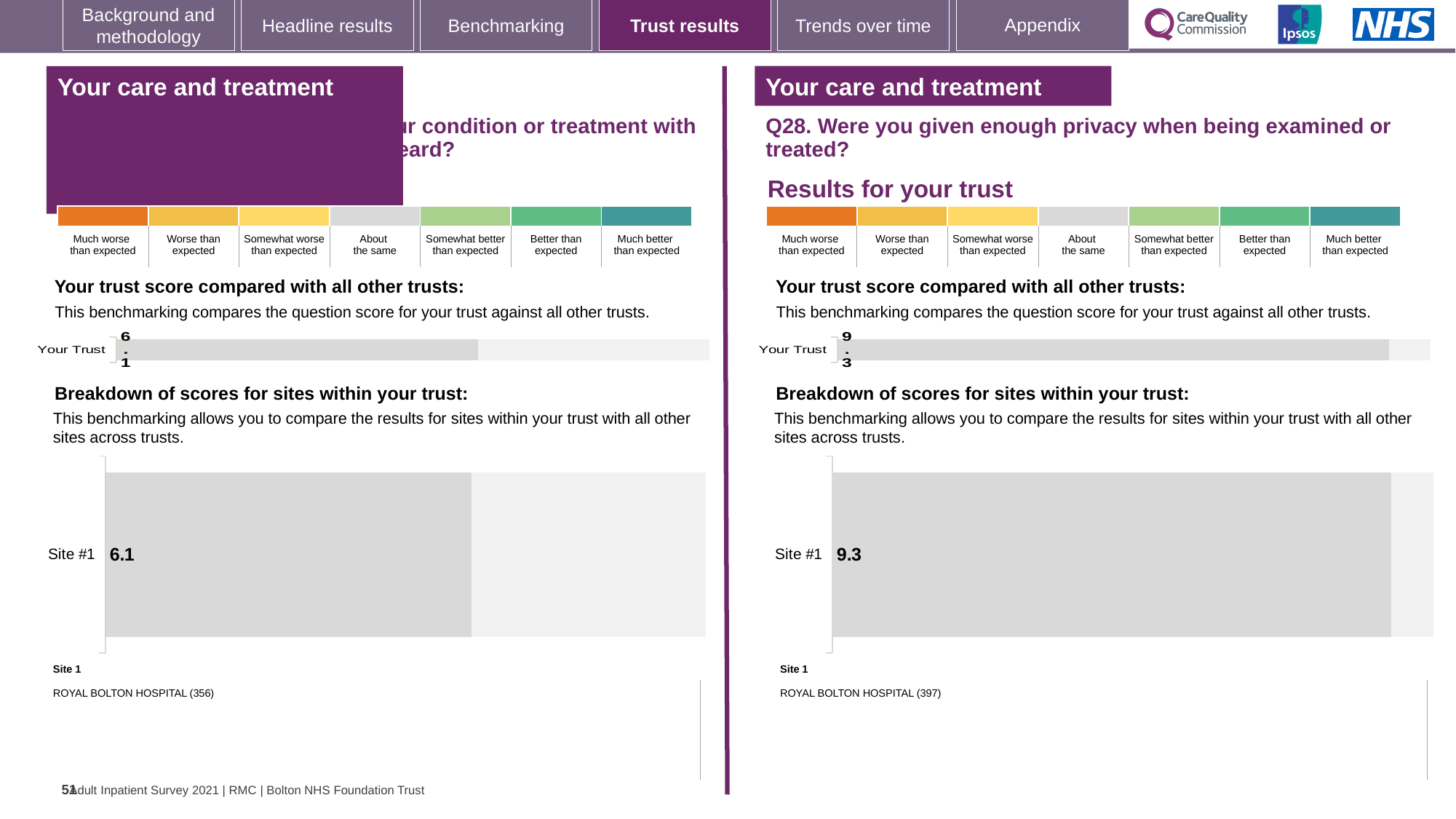
On the right-hand panel (Q28), which hospital is listed as Site 1 below the breakdown chart? ROYAL BOLTON HOSPITAL (397) On the left-hand panel, which hospital is listed as Site 1 below the breakdown chart? ROYAL BOLTON HOSPITAL (356) On the left-hand panel, what score is shown for Site #1 in the breakdown of scores for sites chart? 6.1 How many sites are shown in the breakdown of scores for sites chart on the left-hand panel? 1 On the right-hand panel (Q28, privacy when being examined or treated), what is the score shown for Your Trust? 9.3 How many sites are shown in the breakdown of scores for sites chart on the right-hand panel (Q28)? 1 What type of chart is used to show the Site #1 score on the right-hand panel (Q28)? Bar chart What type of chart is used to show the Your Trust score on the left-hand panel? Bar chart On the left-hand panel, what is the score shown for Your Trust in the trust score chart? 6.1 On the right-hand panel (Q28), what score is shown for Site #1 in the breakdown of scores for sites chart? 9.3 What is the difference between the Site #1 score on the right-hand panel (Q28) and the Site #1 score on the left-hand panel? 3.2 Which is larger: the Your Trust score on the left-hand panel or the Your Trust score on the right-hand panel (Q28)? Right-hand panel (Q28)